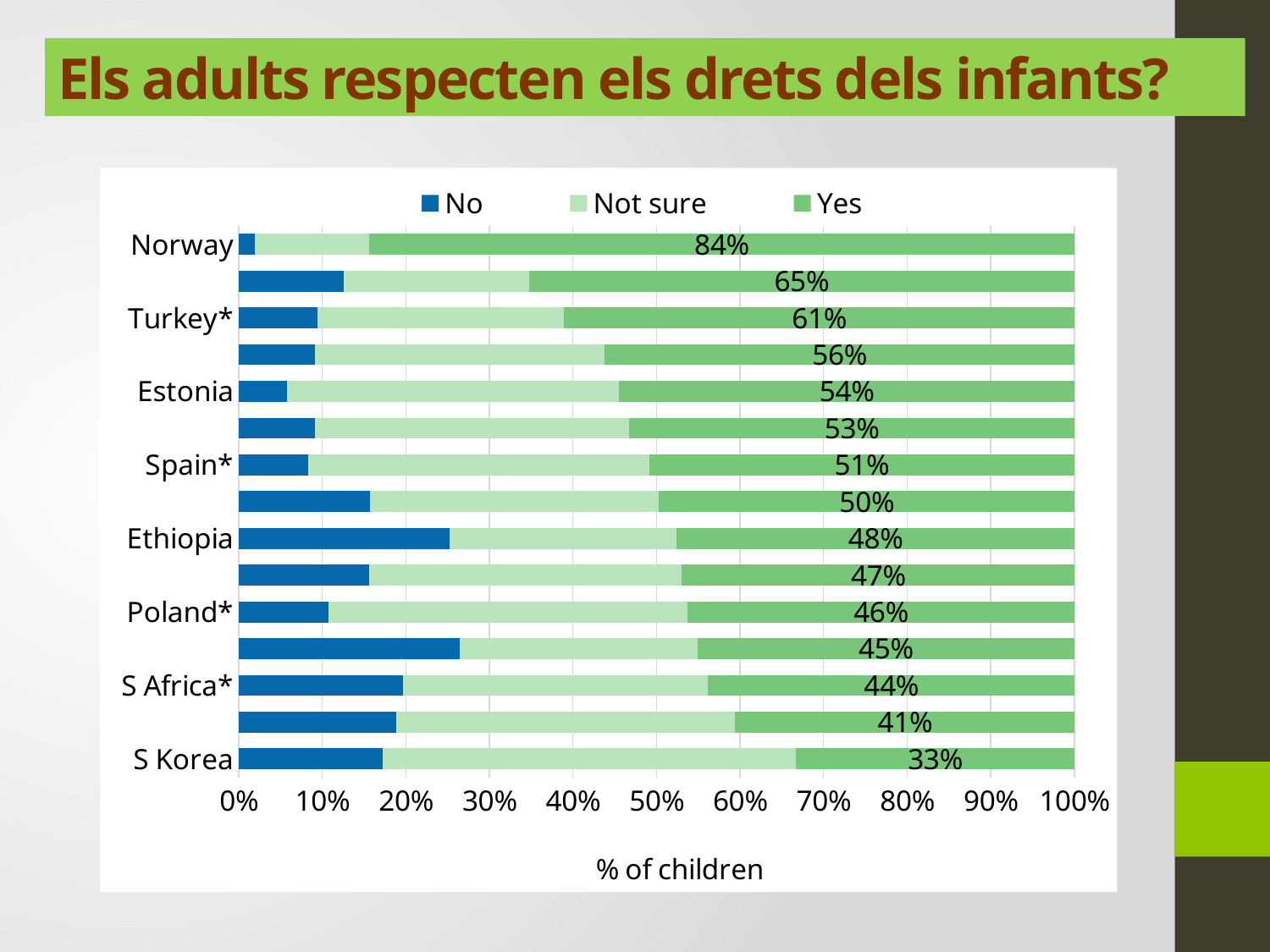
Which labelled country has the highest Yes percentage? Norway Do the Yes values rise or fall going from the top bar to the bottom bar? Fall Which labelled country has the lowest Yes percentage? S Korea Is the No value for Ethiopia greater or less than 20%? greater Which has a higher Yes value, Turkey* or Estonia? Turkey* What is the Yes value for Ethiopia? 48% What percentage of children in Norway answered Yes? 84% What is the Yes value for Spain*? 51% What is the Yes value for S Korea? 33% How many series does the legend list? 3 What is the difference in percentage points between the Yes values for Norway and S Korea? 51 What kind of chart is shown on the slide? Stacked bar chart